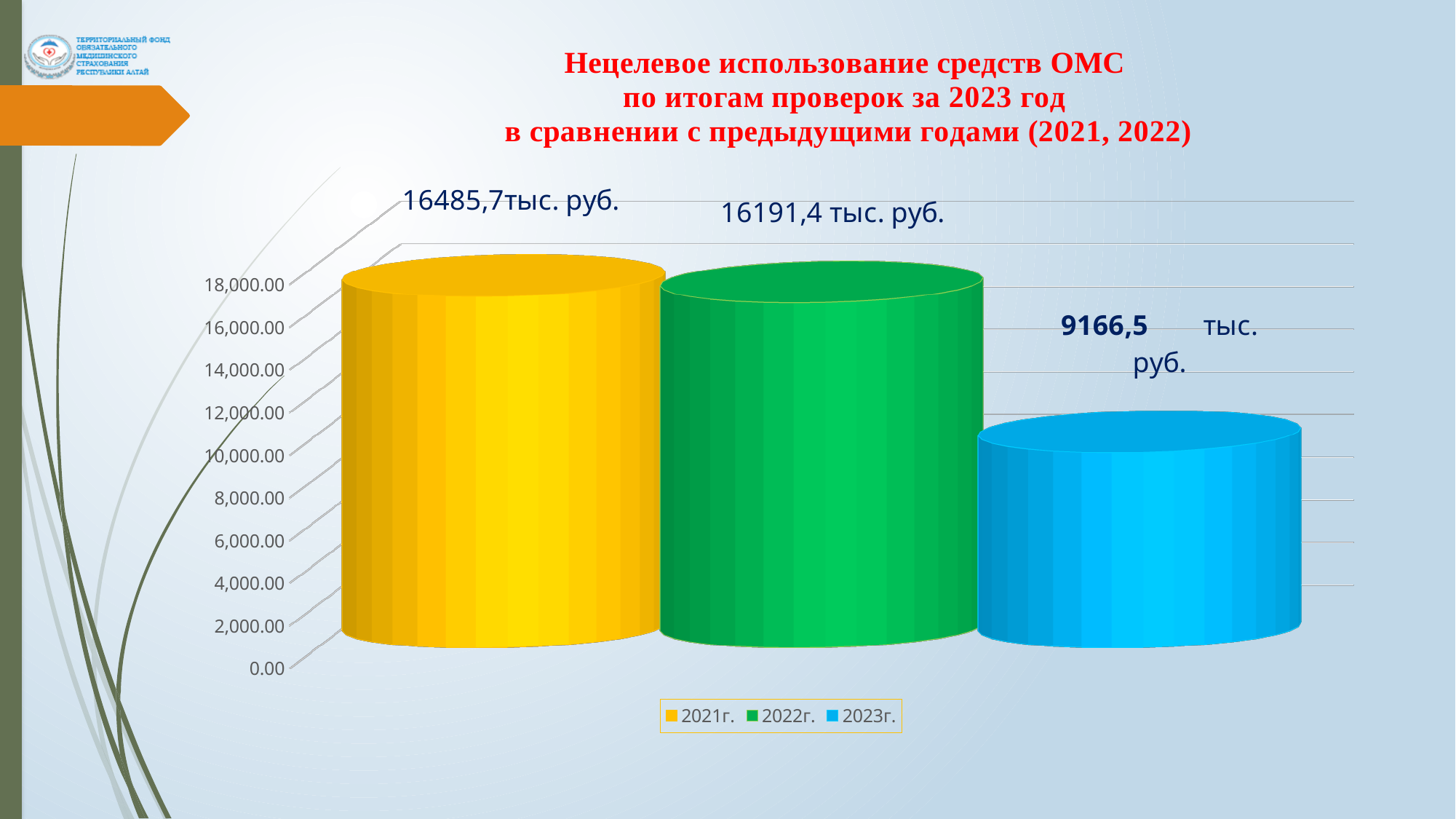
What is the value shown for 2022г.? 16191,4 тыс. руб. Is the value for 2023г. greater or less than 10,000.00? less What is the difference between the values for 2022г. and 2023г.? 7024,9 тыс. руб. Do the values rise or fall from 2021г. to 2023г.? fall What is the value shown for 2023г.? 9166,5 тыс. руб. What kind of chart is shown on the slide? bar chart Which year has the highest value? 2021г. Which year has the lowest value? 2023г. What is the value shown for 2021г.? 16485,7 тыс. руб. Which is larger, the value for 2021г. or the value for 2023г.? 2021г. What is the difference between the values for 2021г. and 2022г.? 294,3 тыс. руб. How many series does the legend list? 3